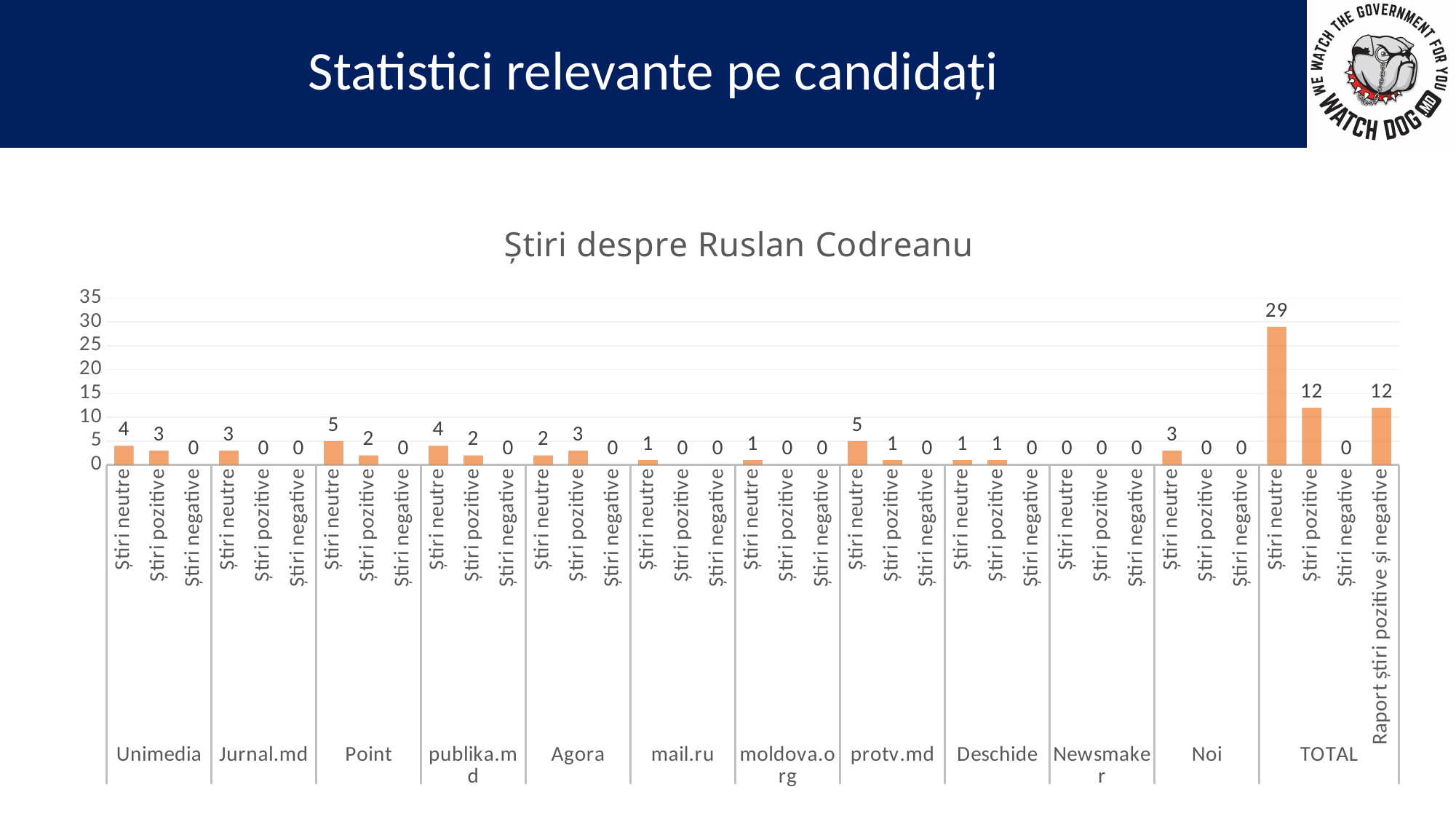
What is the value of Raport știri pozitive și negative? 12 What is the difference between Știri neutre and Știri pozitive in the TOTAL group? 17 Which bar has the highest value in the chart? Știri neutre (TOTAL) What is the value of Știri pozitive in the TOTAL group? 12 What is the value of Știri neutre in the TOTAL group? 29 What kind of chart is shown on the slide? bar chart How many media outlets are shown on the x axis, not counting the TOTAL group? 11 What is the value of Știri pozitive for Agora? 3 What is the value of Știri neutre for Unimedia? 4 What is the value of Știri negative for protv.md? 0 What is the title of the chart? Știri despre Ruslan Codreanu Which is larger: Știri neutre for Point or Știri neutre for Jurnal.md? Știri neutre for Point